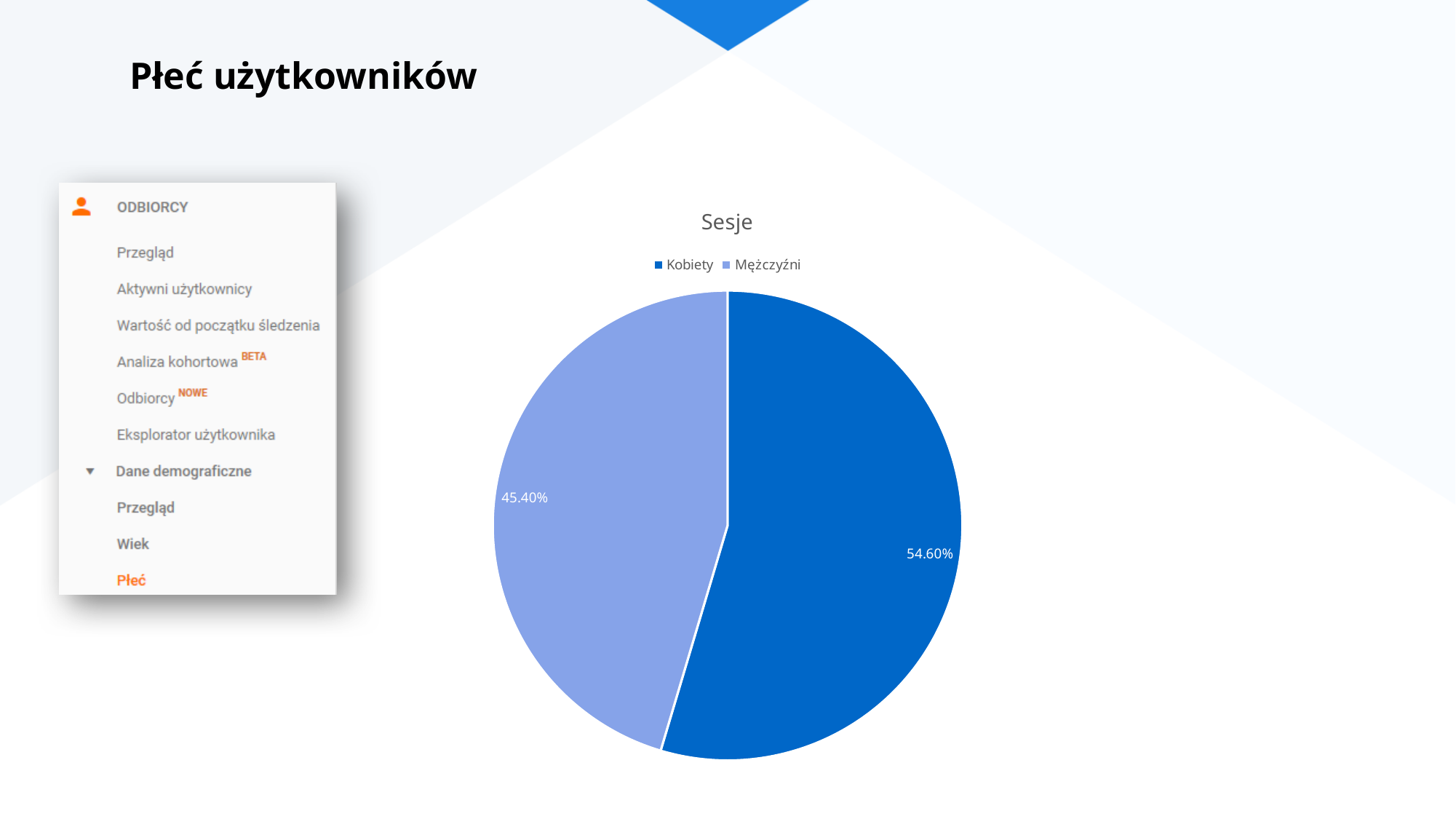
Which category has the largest slice of the pie? Kobiety Which category has the smallest slice of the pie? Mężczyźni Which slice is larger, Kobiety or Mężczyźni? Kobiety How many entries does the legend list? 2 Which legend entry is shown in the darker blue colour? Kobiety What is the difference in percentage points between the Kobiety and Mężczyźni slices? 9.20% What type of chart is shown on the slide? pie chart How many categories does the pie chart show? 2 What share of sessions is attributed to Mężczyźni? 45.40% Is the share for Mężczyźni greater or less than 50%? less What is the title of the chart? Sesje What share of sessions is attributed to Kobiety? 54.60%